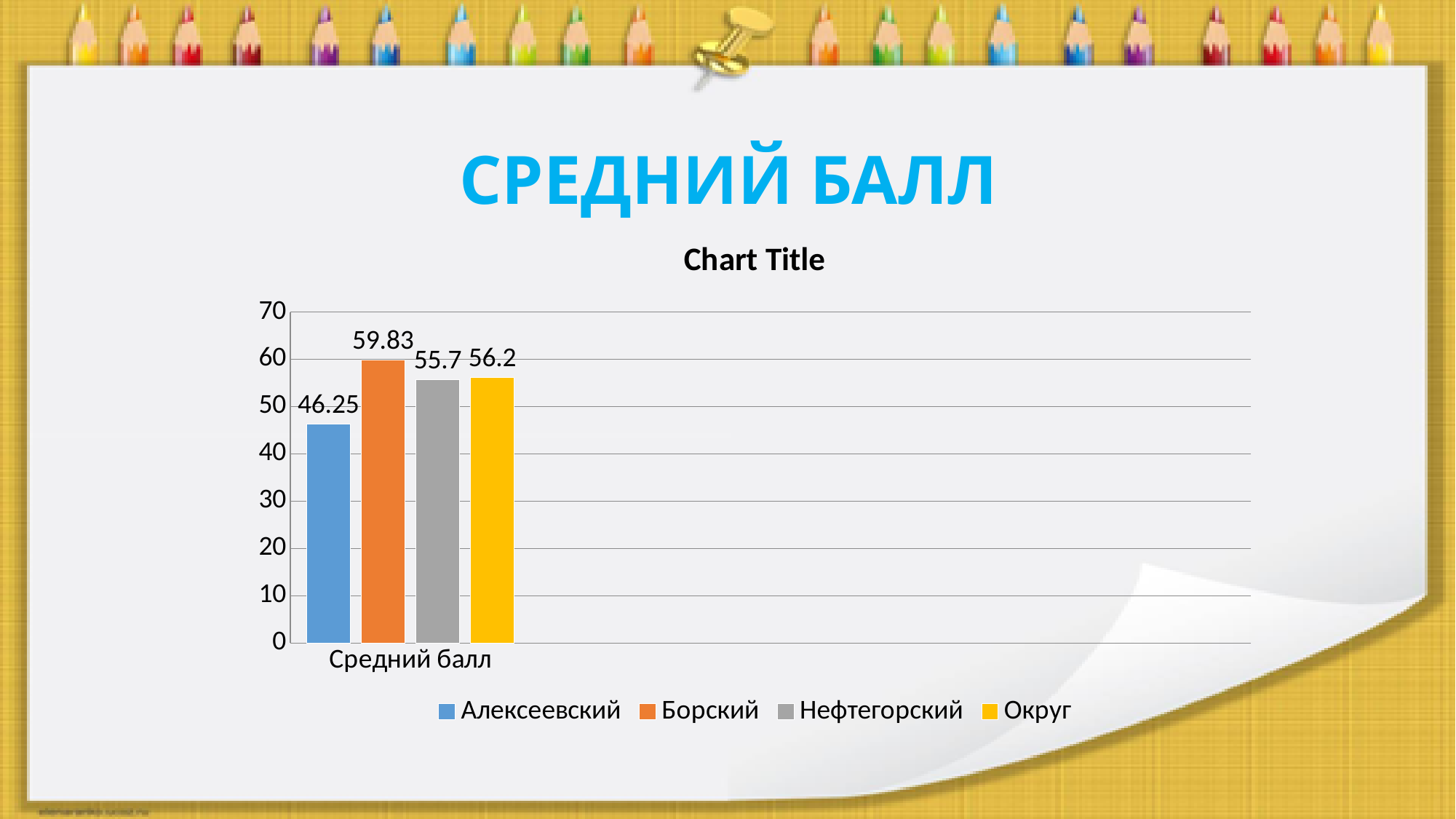
Which series has the highest value? Борский Which series has the lowest value? Алексеевский What is the value for Алексеевский? 46.25 Is the value for Алексеевский greater or less than 50? less How many series does the legend list? 4 What is the value for Борский? 59.83 What kind of chart is shown on the slide? bar chart What is the value for Нефтегорский? 55.7 What is the difference between the values for Борский and Алексеевский? 13.58 Which is larger, the value for Борский or the value for Округ? Борский What is the value for Округ? 56.2 What is the difference between the values for Округ and Нефтегорский? 0.5